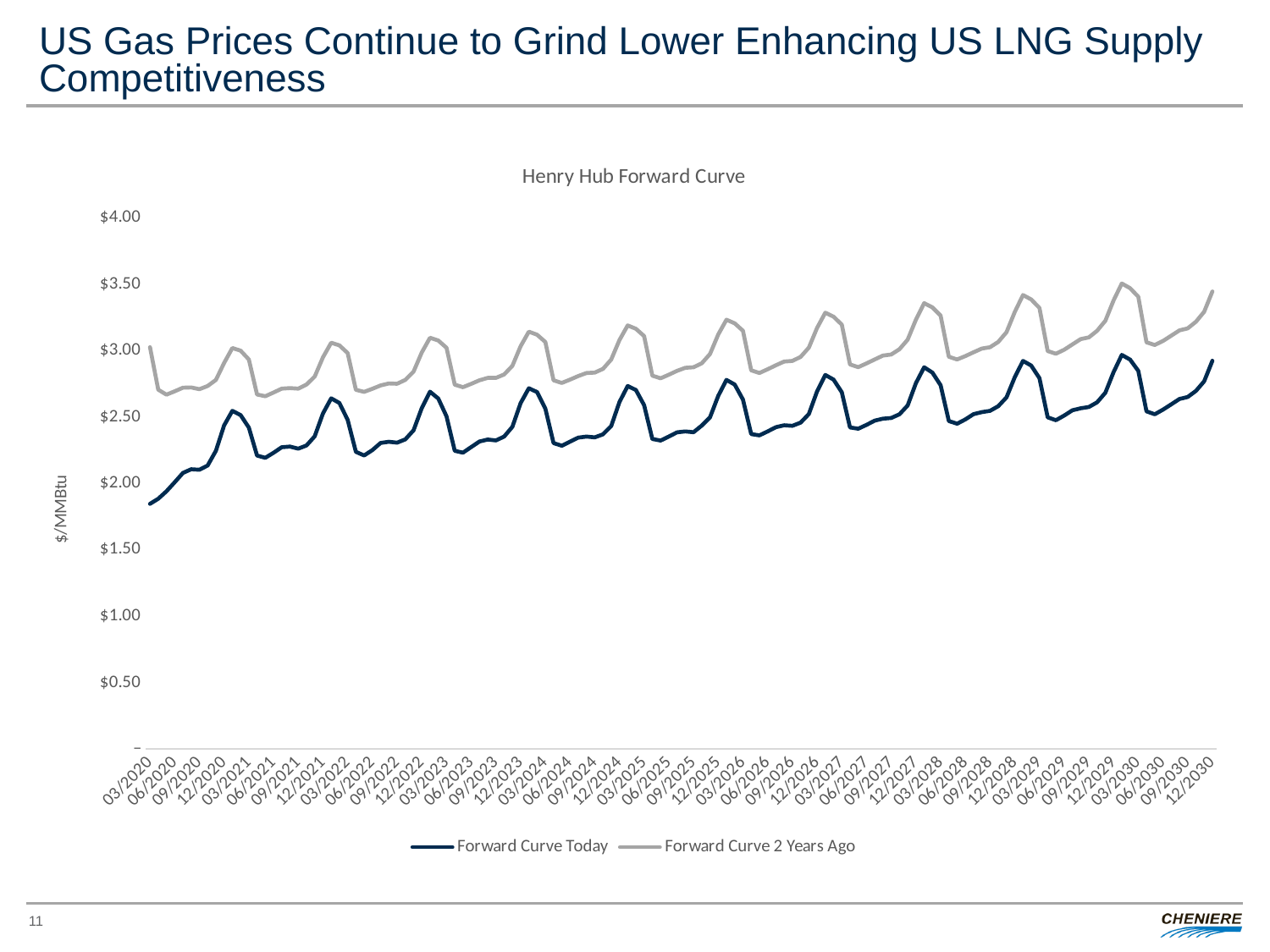
Is the value of Forward Curve Today at 03/2020 greater or less than $2.00? less What kind of chart is shown on the slide? Line chart What is the label on the vertical axis of the chart? $/MMBtu At which x-axis date is the Forward Curve Today series at its lowest? 03/2020 Is the value of Forward Curve Today at 06/2021 greater or less than $2.50? less Is the value of Forward Curve 2 Years Ago at 12/2030 greater or less than $3.00? greater How many date labels are shown along the x axis? 44 Which series is plotted higher across the chart, Forward Curve Today or Forward Curve 2 Years Ago? Forward Curve 2 Years Ago What is the title of the chart? Henry Hub Forward Curve Does the Forward Curve Today series generally rise or fall from 03/2020 to 12/2030? rise How many series does the legend list? 2